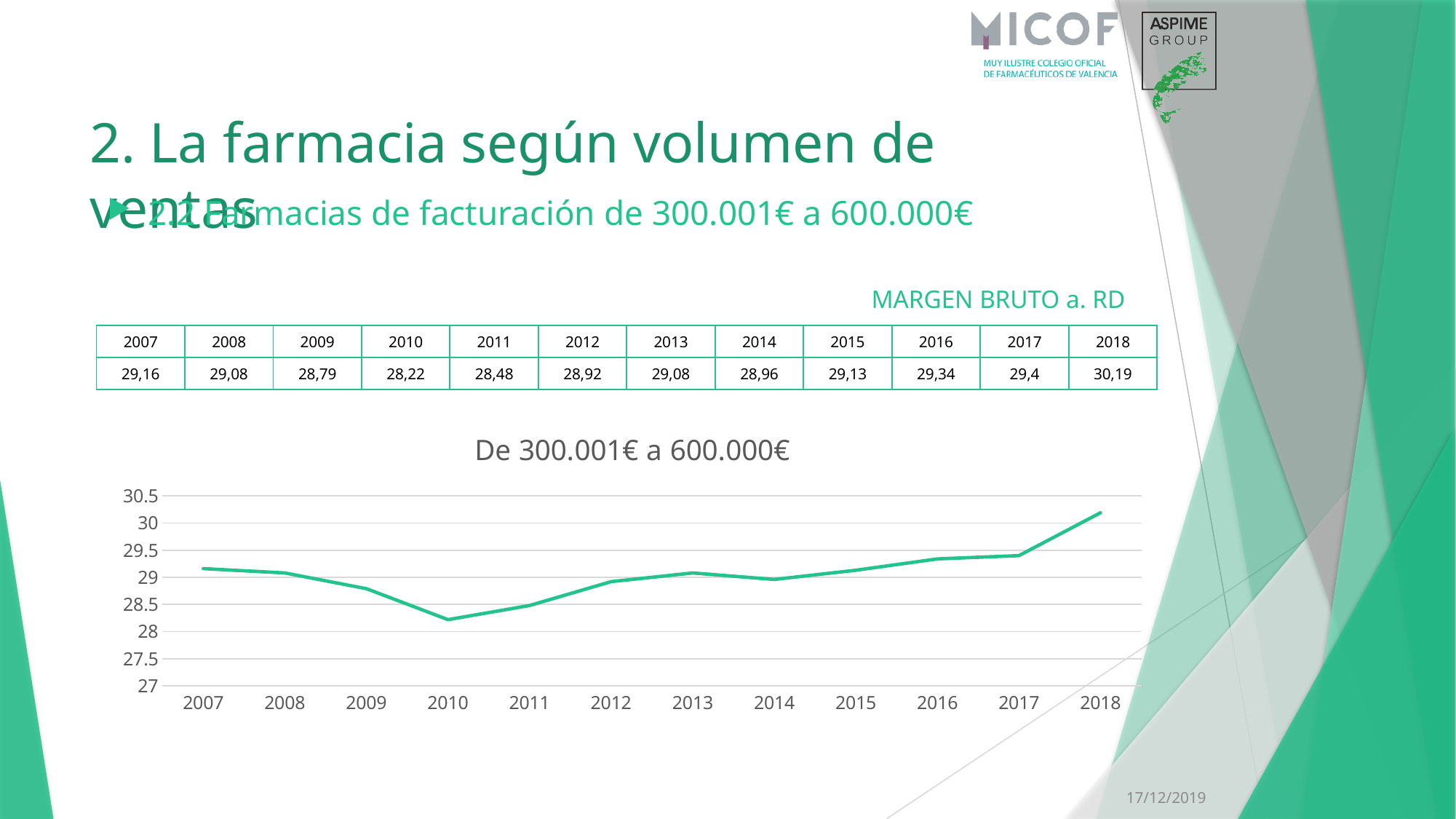
Which year has the highest value? 2018 What is the value for 2014? 28,96 What kind of chart is shown on the slide? line chart What is the chart title? De 300.001€ a 600.000€ Which is larger, the value for 2009 or the value for 2011? 2009 Which year has the lowest value? 2010 Do the values rise or fall from 2010 to 2018? rise Is the value for 2018 greater or less than 30? greater What is the difference between the values for 2018 and 2017? 0,79 What is the value for 2010? 28,22 What is the value for 2018? 30,19 How many years are plotted along the x axis of the chart? 12